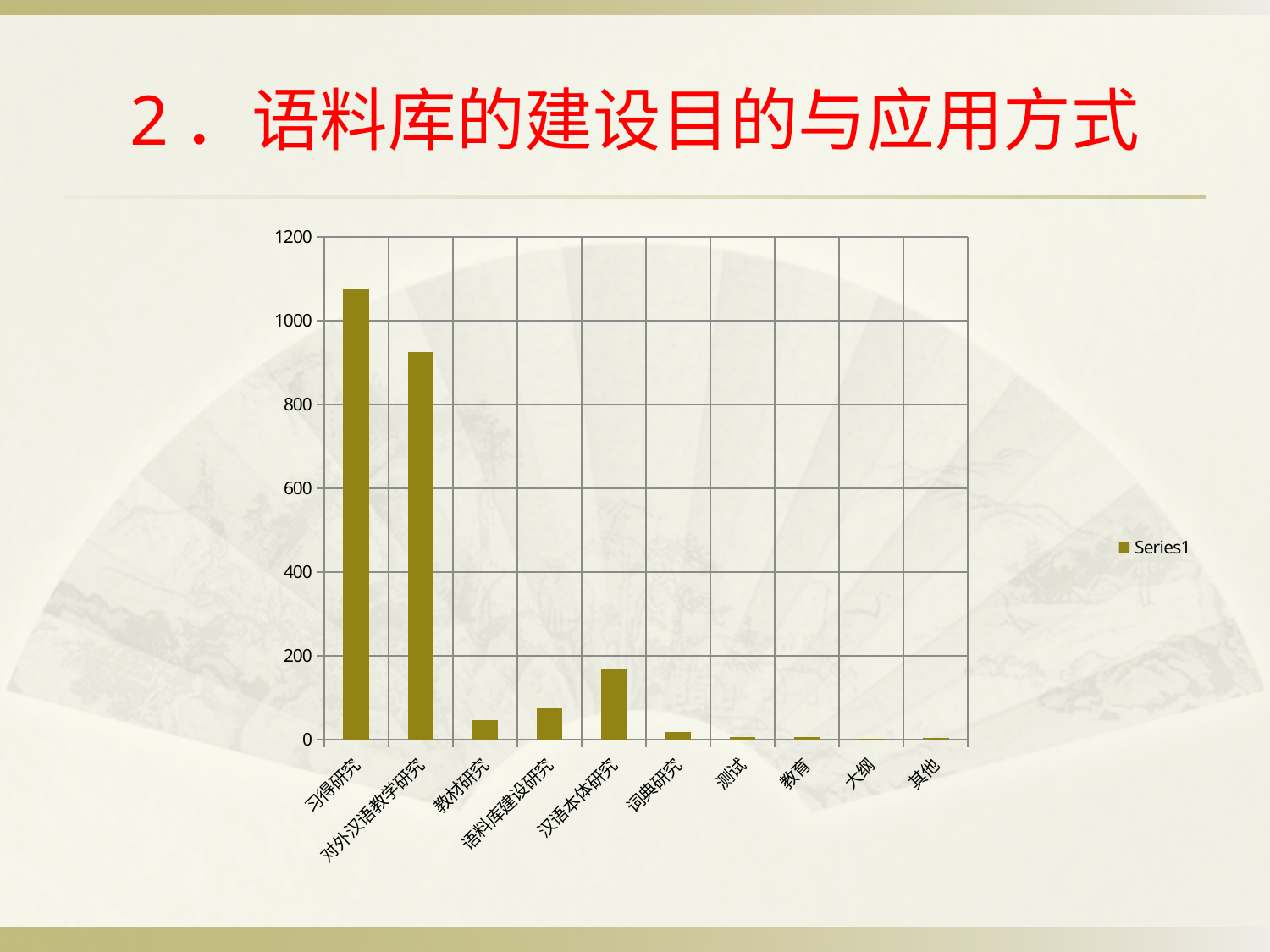
Which is larger, the value for 汉语本体研究 or the value for 语料库建设研究? 汉语本体研究 What is the name of the series shown in the chart legend? Series1 Is the value for 汉语本体研究 greater or less than 200? less Is the value for 习得研究 greater or less than 1000? greater Is the value for 对外汉语教学研究 greater or less than 800? greater Which is larger, the value for 语料库建设研究 or the value for 教材研究? 语料库建设研究 Which is larger, the value for 习得研究 or the value for 对外汉语教学研究? 习得研究 How many series does the chart legend list? 1 Which category has the highest value in the chart? 习得研究 What kind of chart is shown on the slide? bar chart How many categories are shown on the x axis of the chart? 10